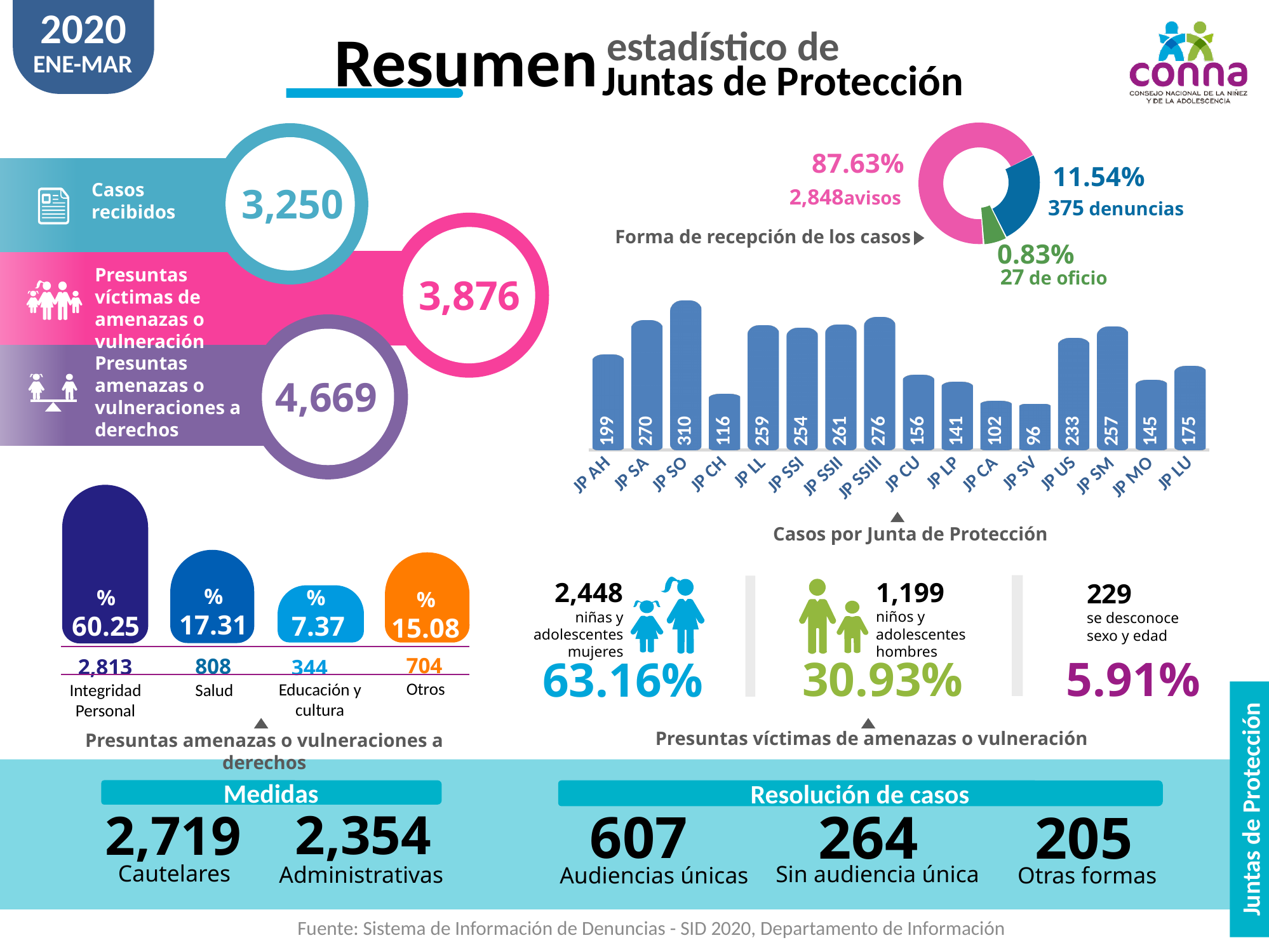
In the 'Forma de recepción de los casos' donut chart, what share of cases were received as avisos? 87.63% In the 'Presuntas amenazas o vulneraciones a derechos' chart, what is the difference between Otros and Educación y cultura? 360 In the 'Forma de recepción de los casos' donut chart, how many cases were denuncias? 375 In the 'Casos por Junta de Protección' chart, what is the difference between JP SA and JP CH? 154 In the 'Casos por Junta de Protección' chart, which Junta has the highest number of cases? JP SO In the 'Casos por Junta de Protección' chart, what is the value for JP SO? 310 In the 'Casos por Junta de Protección' chart, which is larger, JP SSIII or JP US? JP SSIII What kind of chart is 'Casos por Junta de Protección'? Bar chart In the 'Presuntas amenazas o vulneraciones a derechos' chart, what is the value for Salud? 808 How many Juntas are shown in the 'Casos por Junta de Protección' chart? 16 In the 'Casos por Junta de Protección' chart, which Junta has the lowest number of cases? JP SV In the 'Presuntas amenazas o vulneraciones a derechos' chart, which category has the highest percentage? Integridad Personal